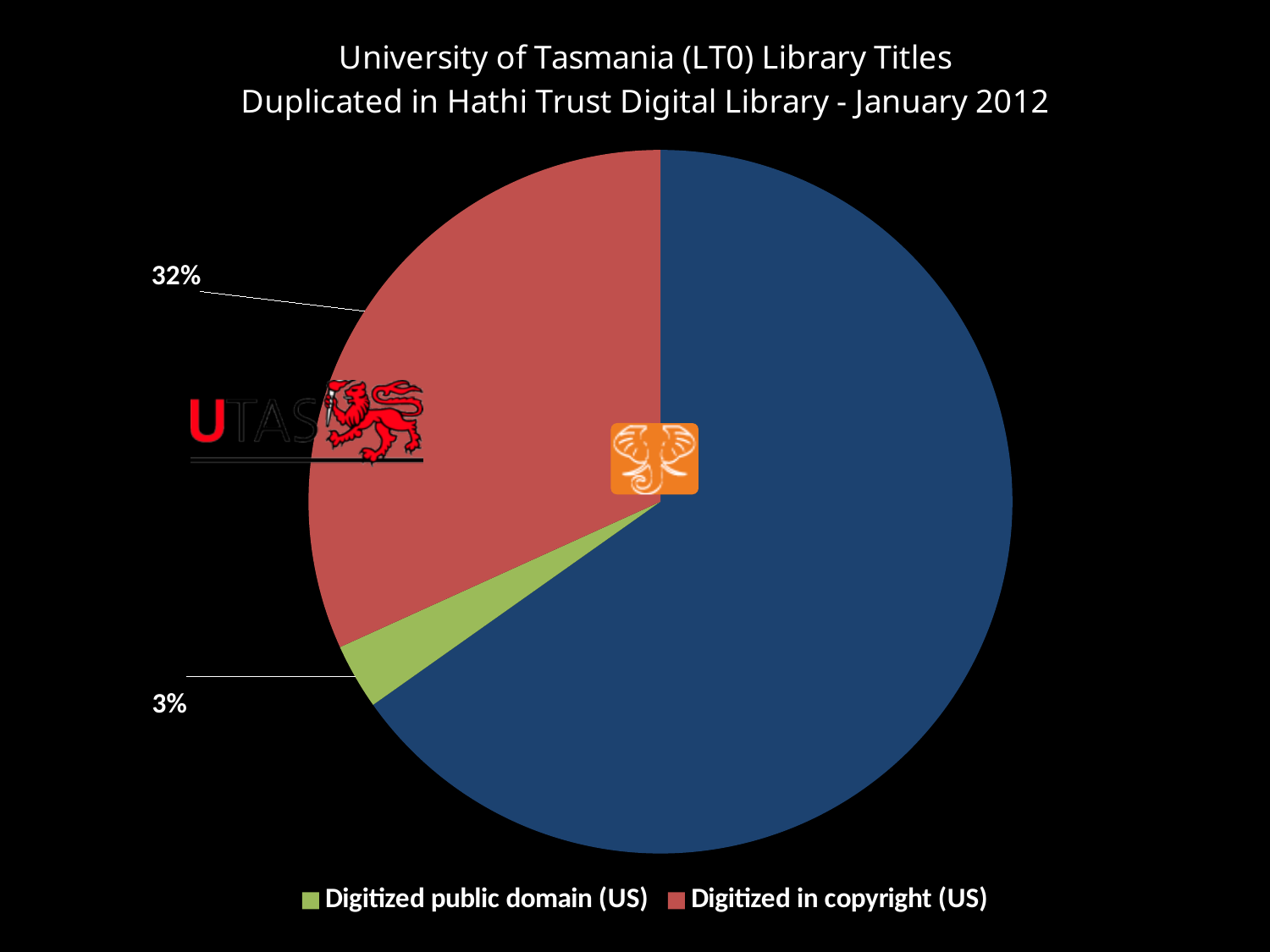
What kind of chart is shown on the slide? Pie chart How many entries does the legend list? 2 How many slices does the pie chart have? 3 What colour is the slice for Digitized public domain (US)? Green Of the two categories listed in the legend, which has the smaller share of the pie? Digitized public domain (US) Of the two categories listed in the legend, which has the larger share of the pie? Digitized in copyright (US) What share of the pie is labelled for Digitized in copyright (US)? 32% What share of the pie is labelled for Digitized public domain (US)? 3% What month and year does the chart title refer to? January 2012 What is the combined share of the two categories listed in the legend? 35% By how many percentage points does the Digitized in copyright (US) share exceed the Digitized public domain (US) share? 29